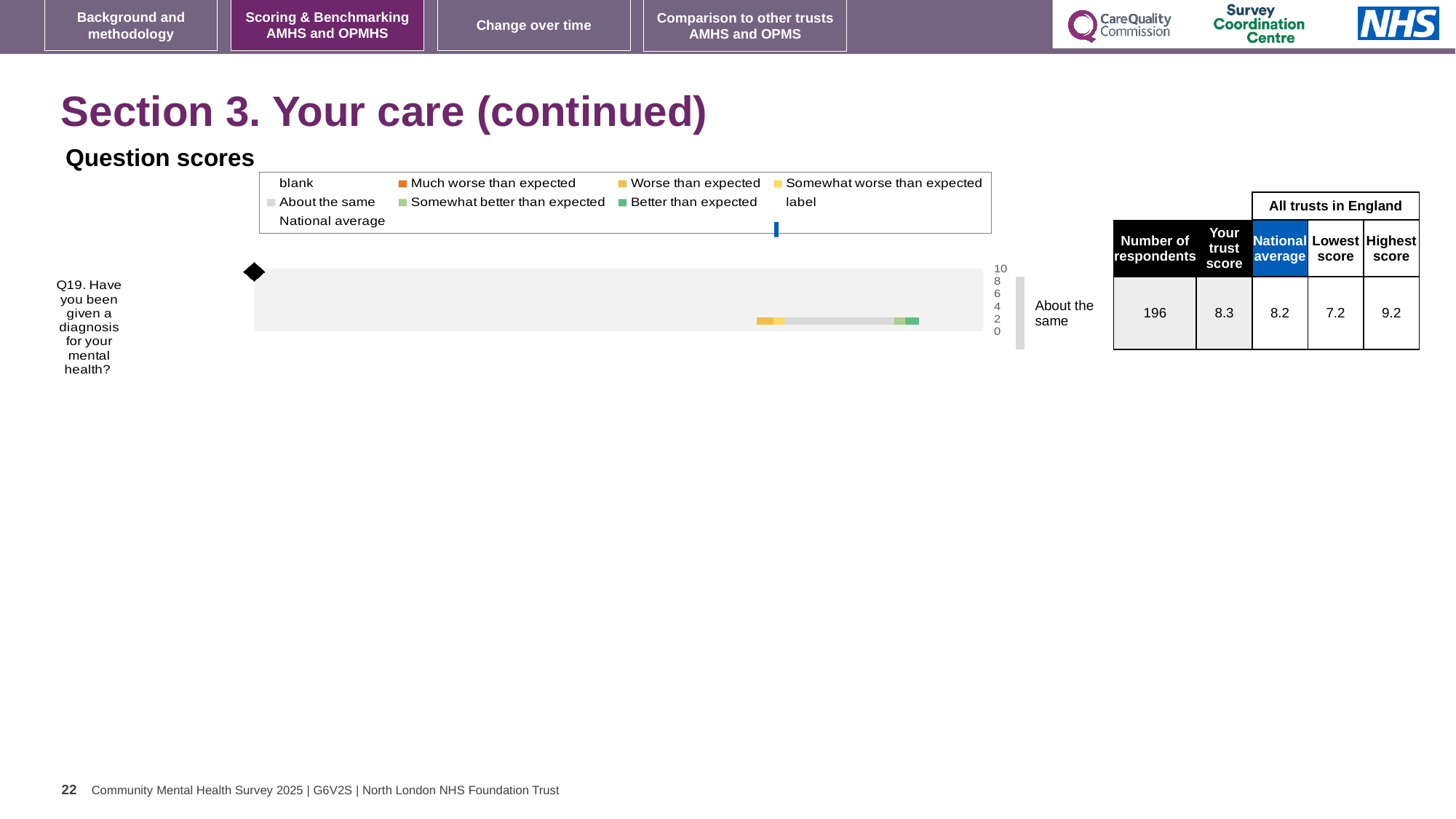
What is the lowest score among all trusts in England for Q19? 7.2 How many questions are plotted on the chart? 1 What kind of chart is used to show the Q19 question score? Bar chart What is the difference between the highest and lowest scores for Q19? 2.0 How many respondents answered Q19? 196 What is the benchmark category shown for Q19? About the same Which is larger for Q19, the trust score or the national average? Trust score Which colour in the legend represents 'Much worse than expected'? Orange Which question is shown on the chart? Q19. Have you been given a diagnosis for your mental health? What is the highest score among all trusts in England for Q19? 9.2 What is the trust score for Q19? 8.3 What is the national average for Q19? 8.2